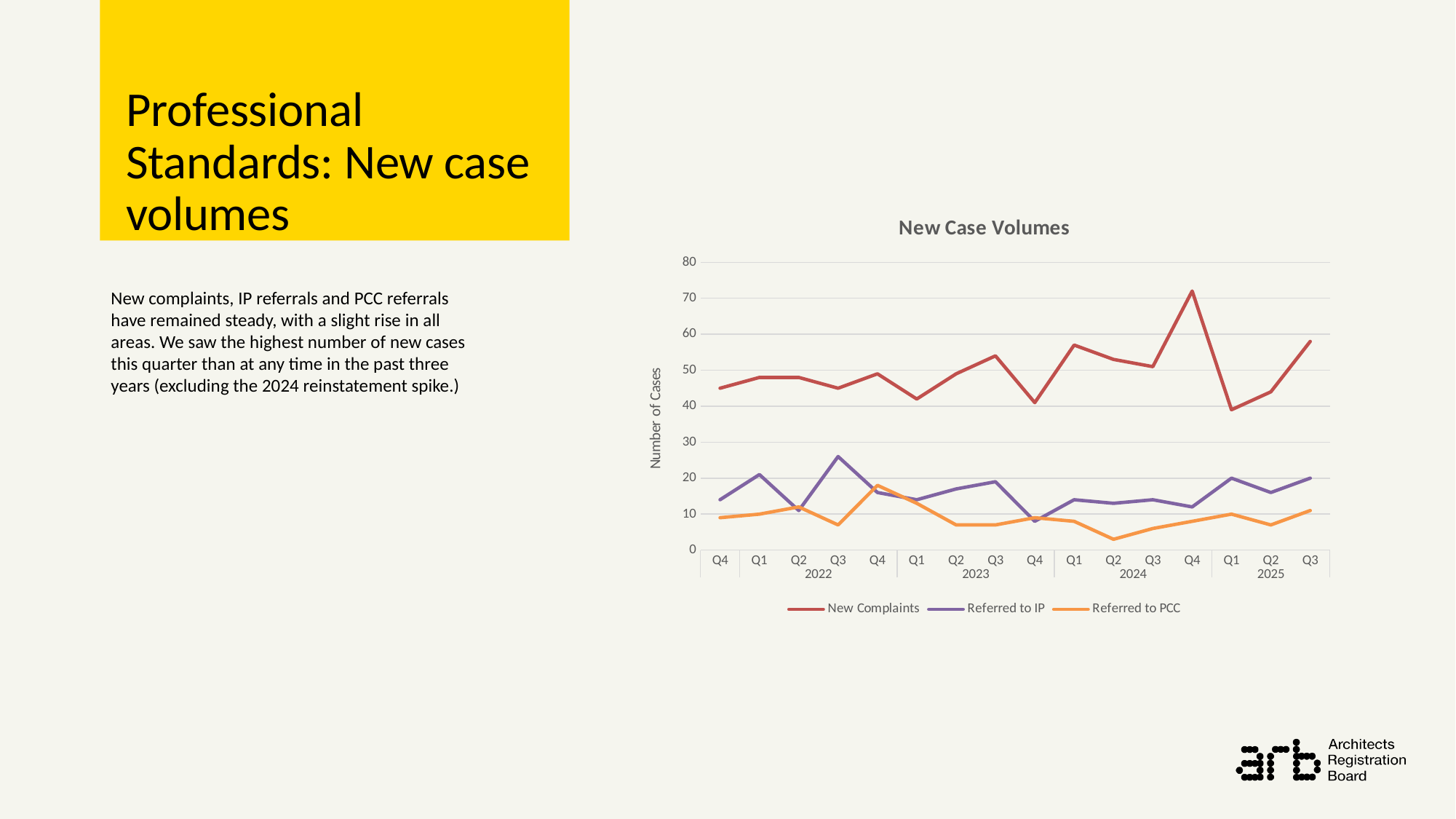
How many series does the legend list? 3 In which quarter does the New Complaints series reach its highest value? Q4 2024 What is the title of the chart? New Case Volumes How many quarterly points are plotted along the x axis? 16 What kind of chart is shown on the slide? line chart In which quarter does the Referred to PCC series reach its lowest value? Q2 2024 In which quarter does the Referred to IP series reach its highest value? Q3 2022 Is the value for Referred to IP in Q3 2022 greater or less than 20? greater Is the value for Referred to PCC in Q2 2024 greater or less than 5? less Does the New Complaints series rise or fall from Q1 2025 to Q3 2025? rise Which is larger in Q3 2022: Referred to IP or Referred to PCC? Referred to IP Is the value for New Complaints in Q4 2024 greater or less than 60? greater